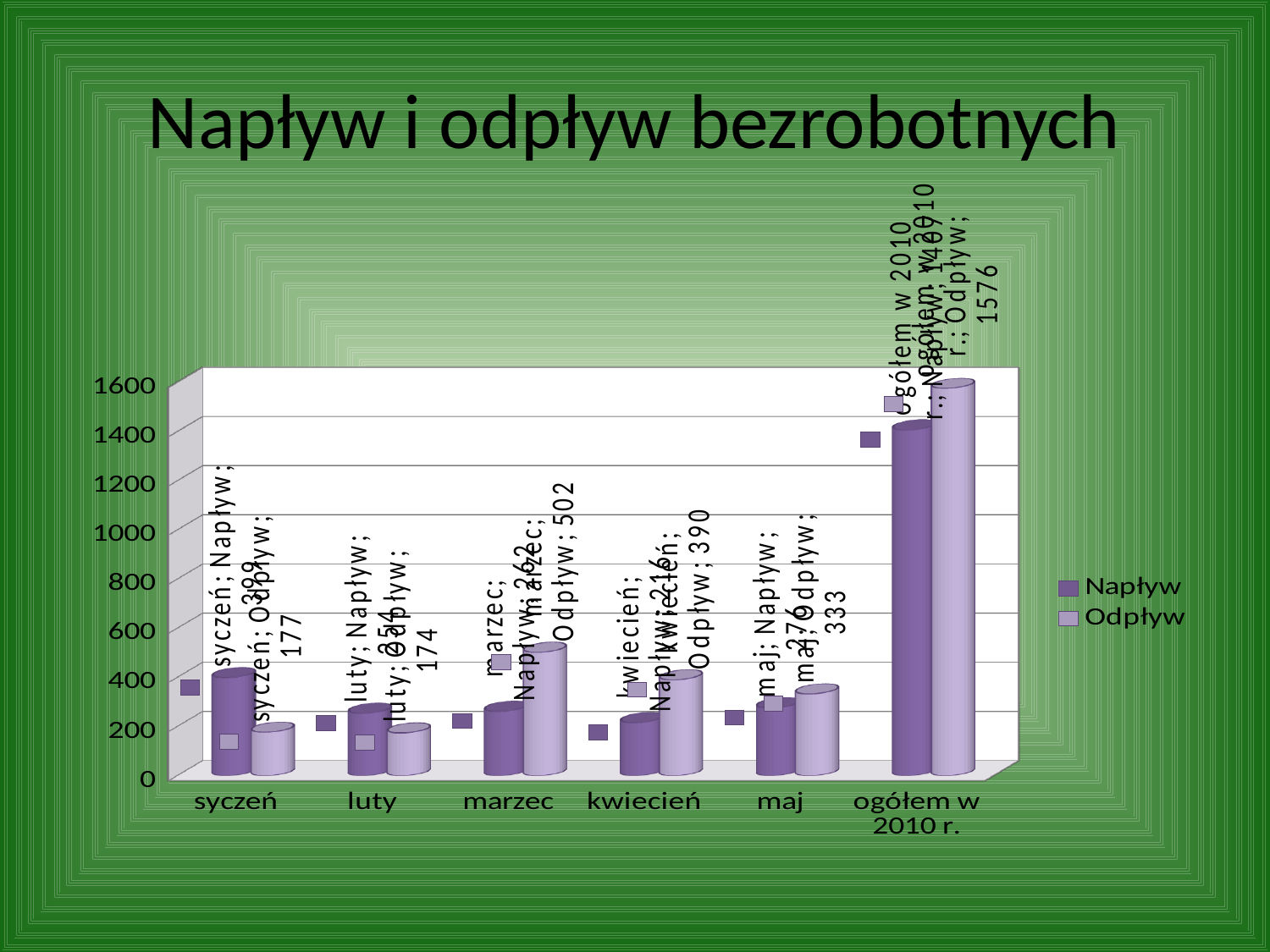
What kind of chart is shown on the slide? bar chart Which category has the highest Odpływ value? ogółem w 2010 r. For styczeń, which is larger: Napływ or Odpływ? Napływ Is the Napływ value for ogółem w 2010 r. greater or less than 1200? greater What is the Odpływ value for maj? 333 How many series does the legend list? 2 What is the Odpływ value for kwiecień? 390 What is the Odpływ value for marzec? 502 Which category has the lowest Odpływ value? luty How many categories are shown on the x axis? 6 What is the Odpływ value for ogółem w 2010 r.? 1576 What is the difference between the Odpływ values for marzec and kwiecień? 112